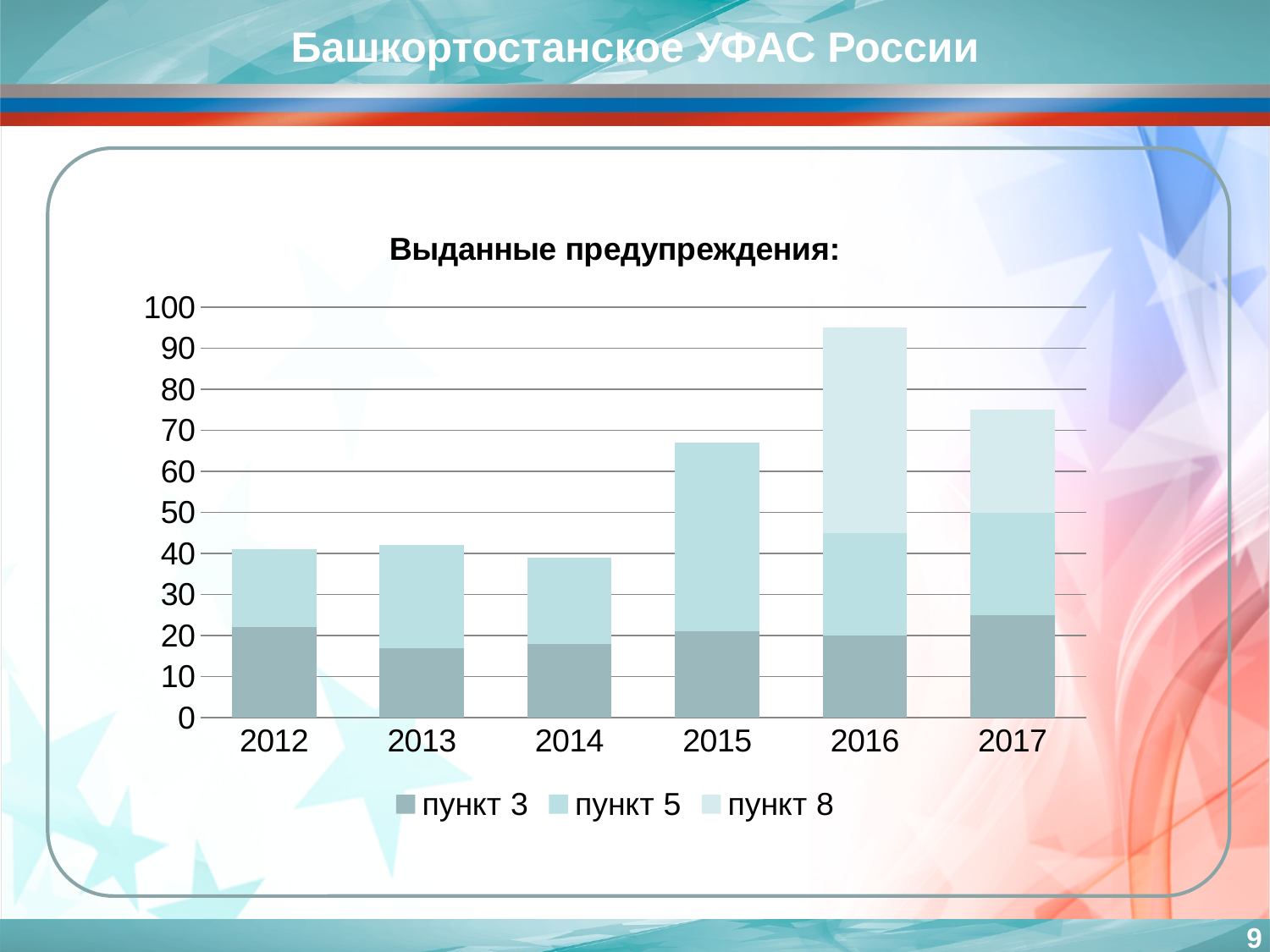
Is the total bar for 2017 greater or less than 70? greater Is the total bar for 2015 greater or less than 60? greater What kind of chart is shown on the slide? stacked bar chart Is the total bar for 2016 greater or less than 90? greater Which year has the highest total bar? 2016 How many years are shown on the x axis? 6 Which total bar is larger, 2016 or 2017? 2016 How many series does the legend list? 3 Which total bar is larger, 2014 or 2015? 2015 What is the title of the chart? Выданные предупреждения: Do the total bars rise or fall from 2014 to 2016? rise